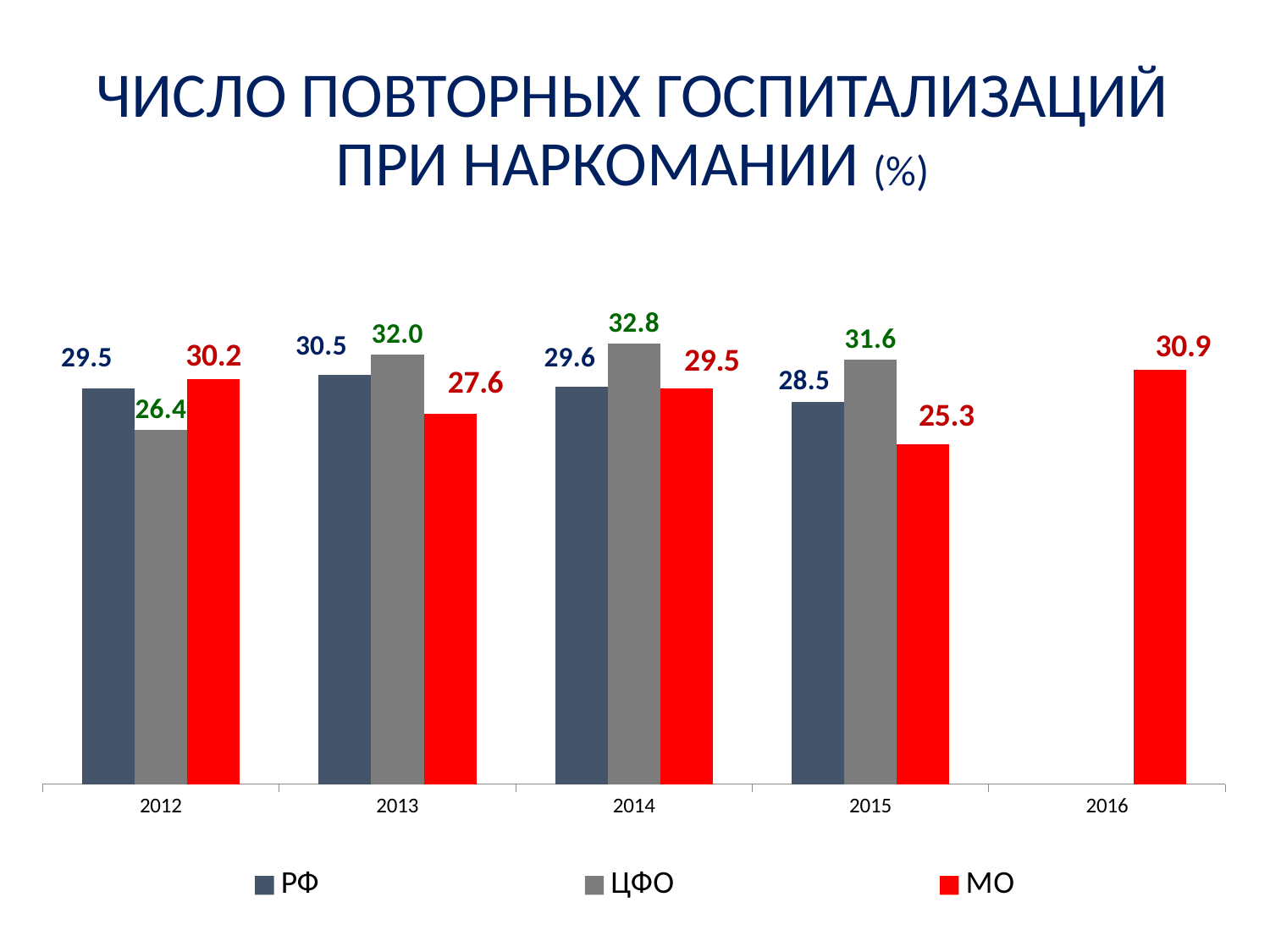
How many series does the legend list? 3 What is the value for ЦФО in 2014? 32.8 What is the difference between the ЦФО and МО values in 2015? 6.3 What is the value for МО in 2016? 30.9 What is the value for РФ in 2015? 28.5 Which is larger in 2012, the РФ value or the ЦФО value? РФ In which year is the ЦФО value highest? 2014 Does the МО value rise or fall from 2012 to 2015? fall Which series is shown in red? МО How many years are shown on the x axis? 5 In which year is the МО value lowest? 2015 What kind of chart is shown on the slide? bar chart